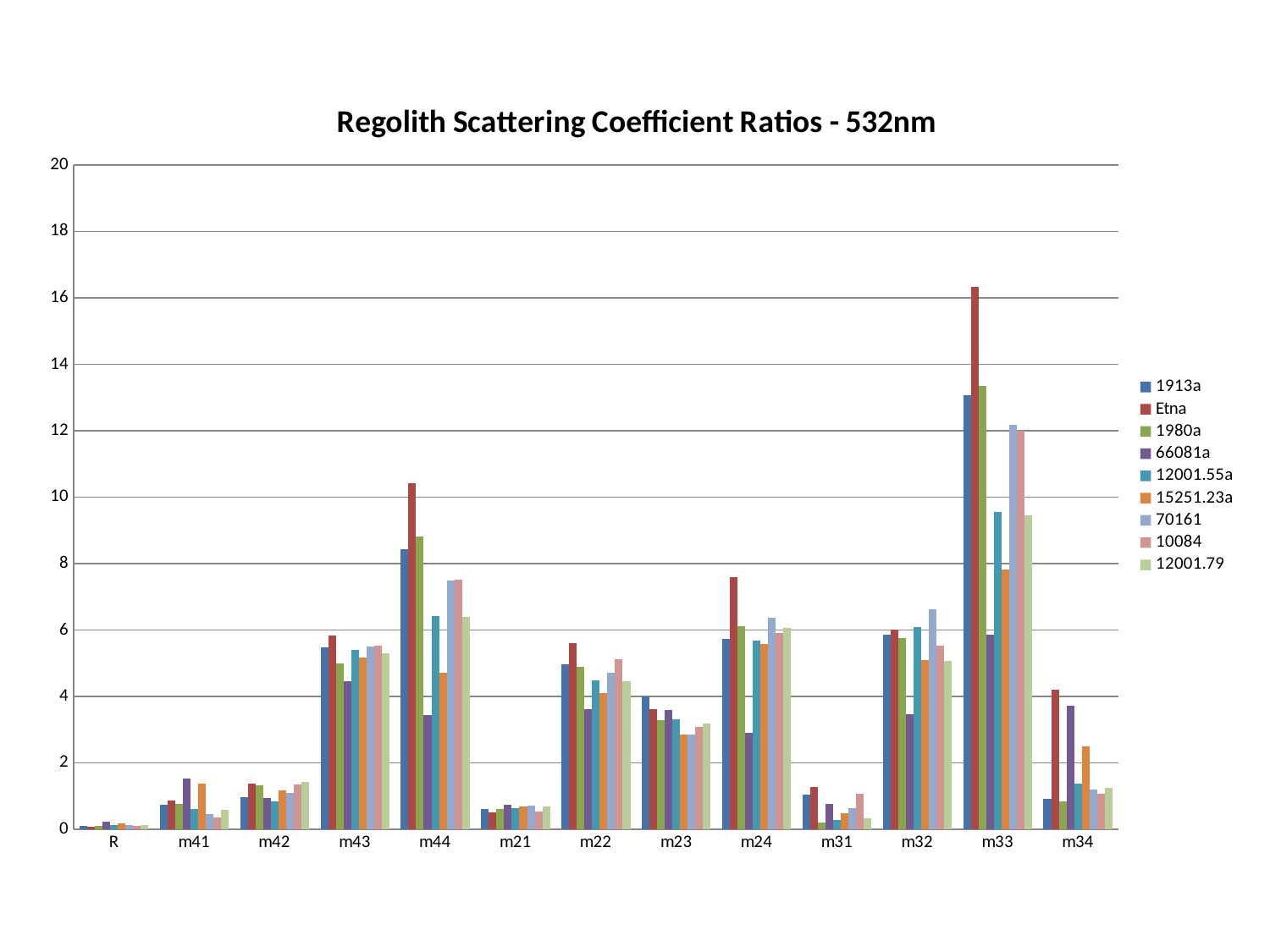
For m34, which is larger: the Etna value or the 1913a value? Etna Is the 66081a value for m44 greater or less than 4? less How many categories are shown on the x axis? 13 Which category has the highest Etna value? m33 What is the title of the chart? Regolith Scattering Coefficient Ratios - 532nm Is the Etna value for m44 greater or less than 8? greater Which category has the highest 1913a value? m33 Is the Etna value for m33 greater or less than 14? greater What kind of chart is shown on the slide? bar chart How many series does the legend list? 9 For m33, which is larger: the Etna value or the 1913a value? Etna